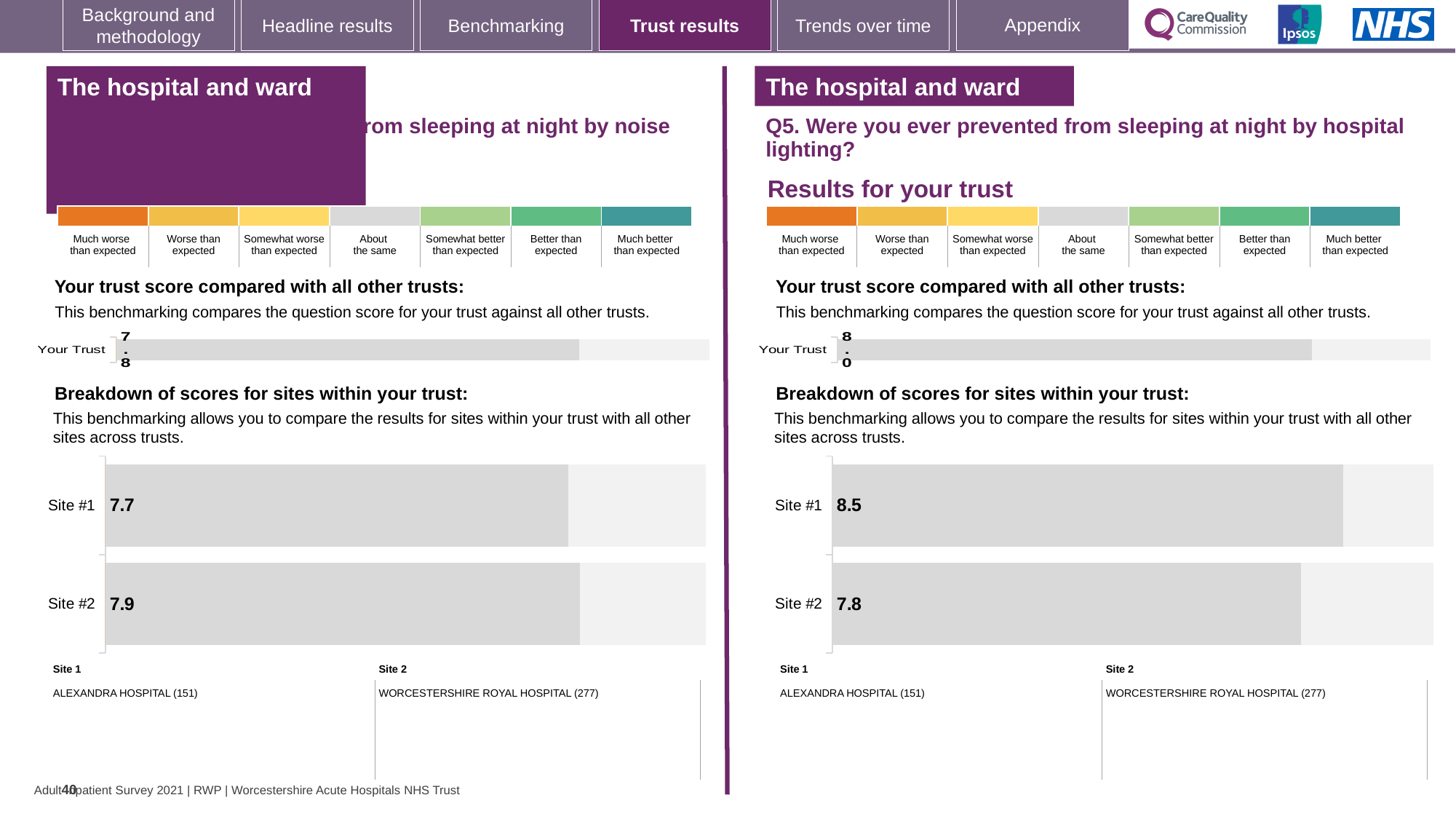
On the right-hand chart for Q5 (hospital lighting), what is the score for Site #2? 7.8 What type of chart is used for the site breakdown on the right-hand side for Q5 (hospital lighting)? Bar chart On the right-hand chart for Q5 (hospital lighting), what is the score for Site #1? 8.5 On the left-hand site breakdown chart (sleeping at night by noise), which site has the lower score? Site #1 On the right-hand site breakdown chart for Q5 (hospital lighting), what is the difference between the Site #1 and Site #2 scores? 0.7 On the left-hand site breakdown chart (sleeping at night by noise), what is the score for Site #1? 7.7 On the right-hand 'Your trust score compared with all other trusts' chart for Q5 (hospital lighting), what is the score for Your Trust? 8.0 On the right-hand site breakdown chart for Q5 (hospital lighting), which site has the higher score? Site #1 On the left-hand site breakdown chart (sleeping at night by noise), what is the score for Site #2? 7.9 How many sites are shown in the right-hand site breakdown chart for Q5 (hospital lighting)? 2 On the left-hand 'Your trust score compared with all other trusts' chart (sleeping at night by noise), what is the score for Your Trust? 7.8 On the left-hand site breakdown chart (sleeping at night by noise), what is the difference between the Site #2 and Site #1 scores? 0.2